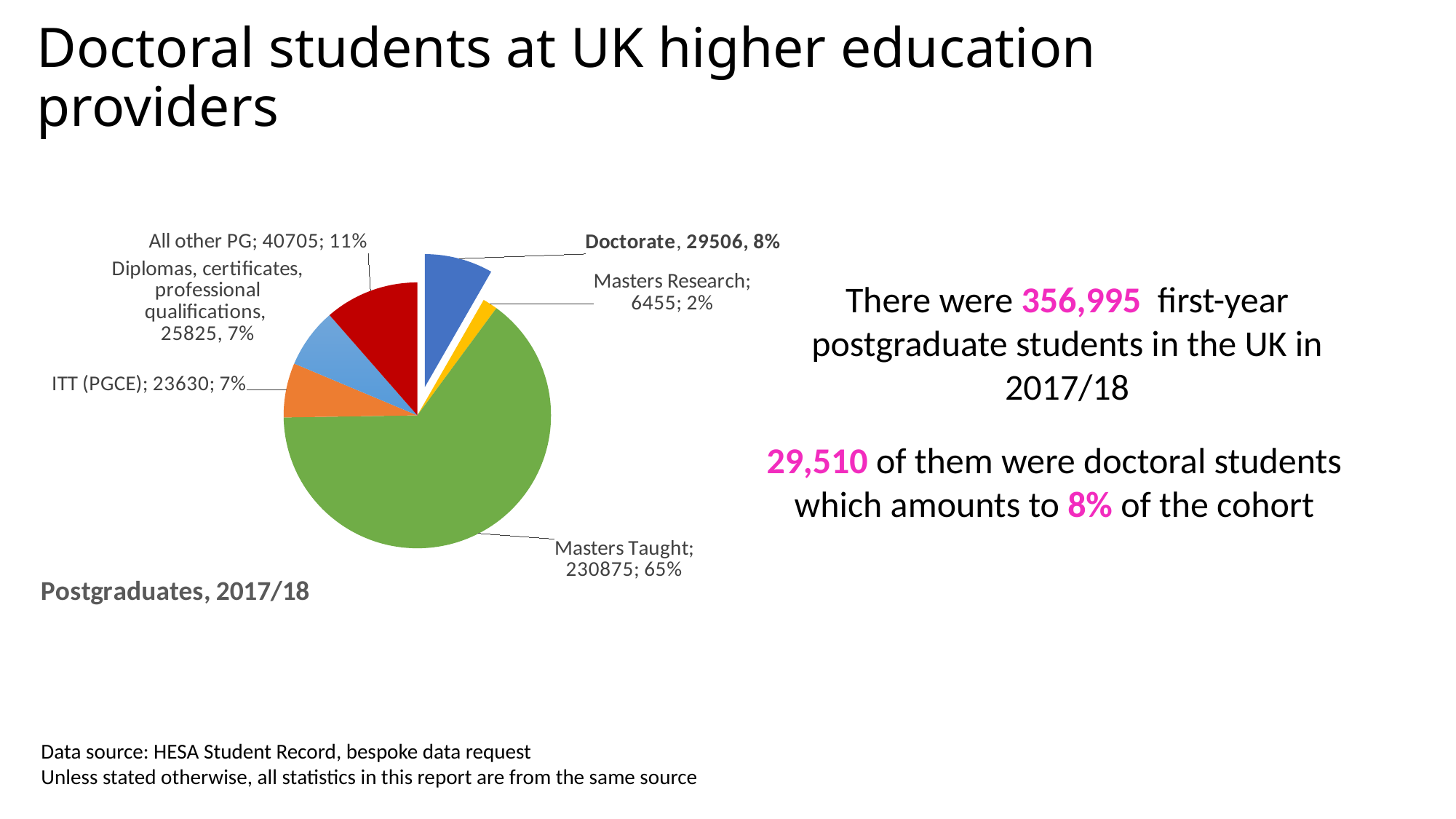
Which is larger, the value for ITT (PGCE) or the value for Diplomas, certificates, professional qualifications? Diplomas, certificates, professional qualifications What kind of chart is shown on the slide? Pie chart What is the value for Masters Research in the pie chart? 6455 What is the value for Doctorate in the pie chart? 29506 Which category has the largest slice of the pie chart? Masters Taught How many slices does the pie chart have? 6 What share of the pie does Doctorate represent? 8% What is the value for All other PG in the pie chart? 40705 What is the difference between the values for All other PG and Doctorate? 11199 Which category has the smallest slice of the pie chart? Masters Research What is the value for Masters Taught in the pie chart? 230875 What share of the pie does Masters Taught represent? 65%